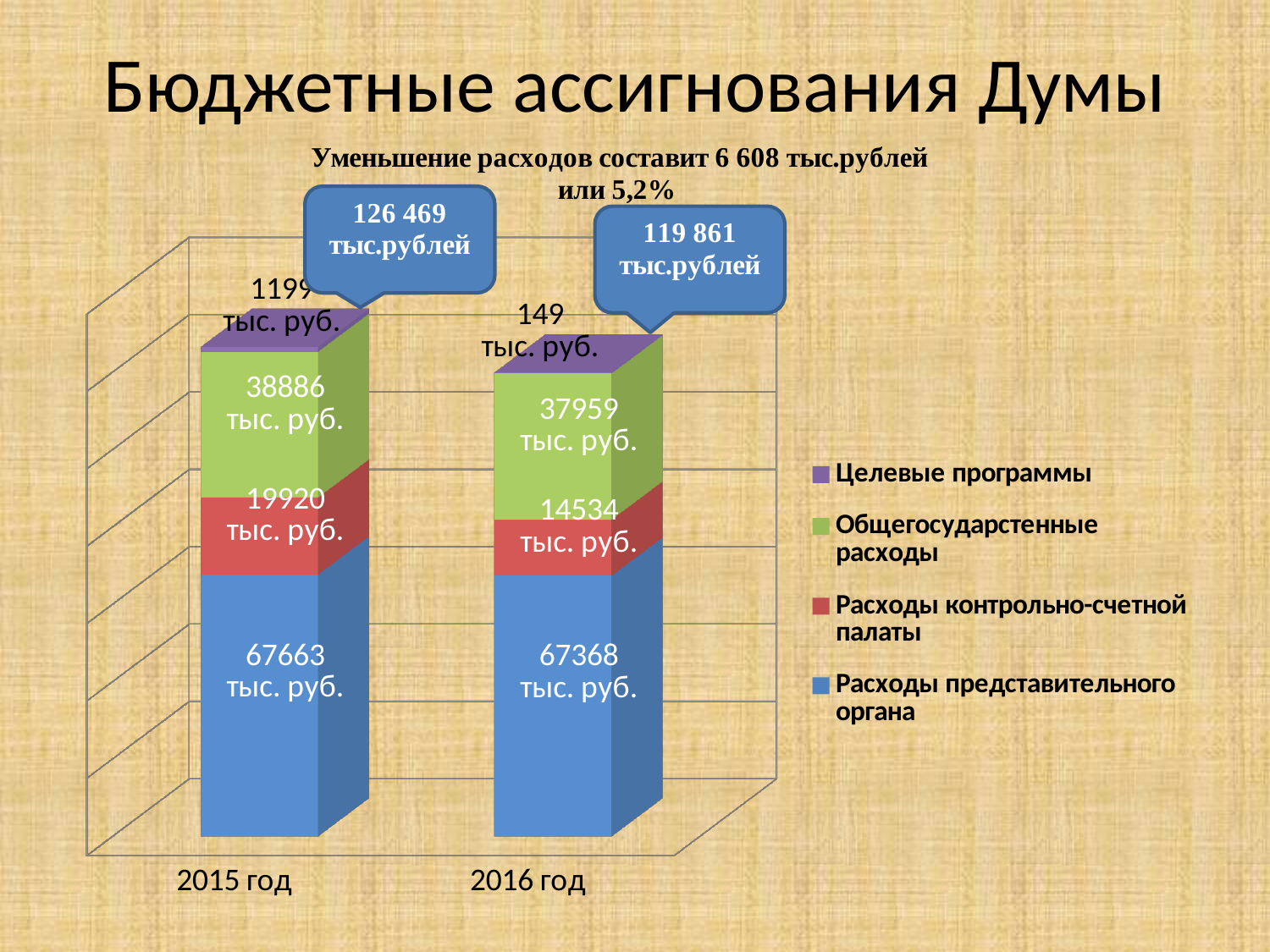
What kind of chart is shown on the slide? Stacked bar chart What is the value of Расходы представительного органа for 2015 год? 67663 тыс. руб. What is the value of Расходы контрольно-счетной палаты for 2016 год? 14534 тыс. руб. Which series has the largest value in the 2016 год bar? Расходы представительного органа What is the value of Целевые программы for 2016 год? 149 тыс. руб. How many series does the chart legend list? 4 How many years (categories) are shown on the x axis of the chart? 2 What is the value of Общегосударстенные расходы for 2016 год? 37959 тыс. руб. By how much did Расходы контрольно-счетной палаты decrease from 2015 год to 2016 год? 5386 тыс. руб. What colour represents Целевые программы in the chart? Purple Which year has the larger value for Расходы представительного органа, 2015 год or 2016 год? 2015 год What is the value of Общегосударстенные расходы for 2015 год? 38886 тыс. руб.